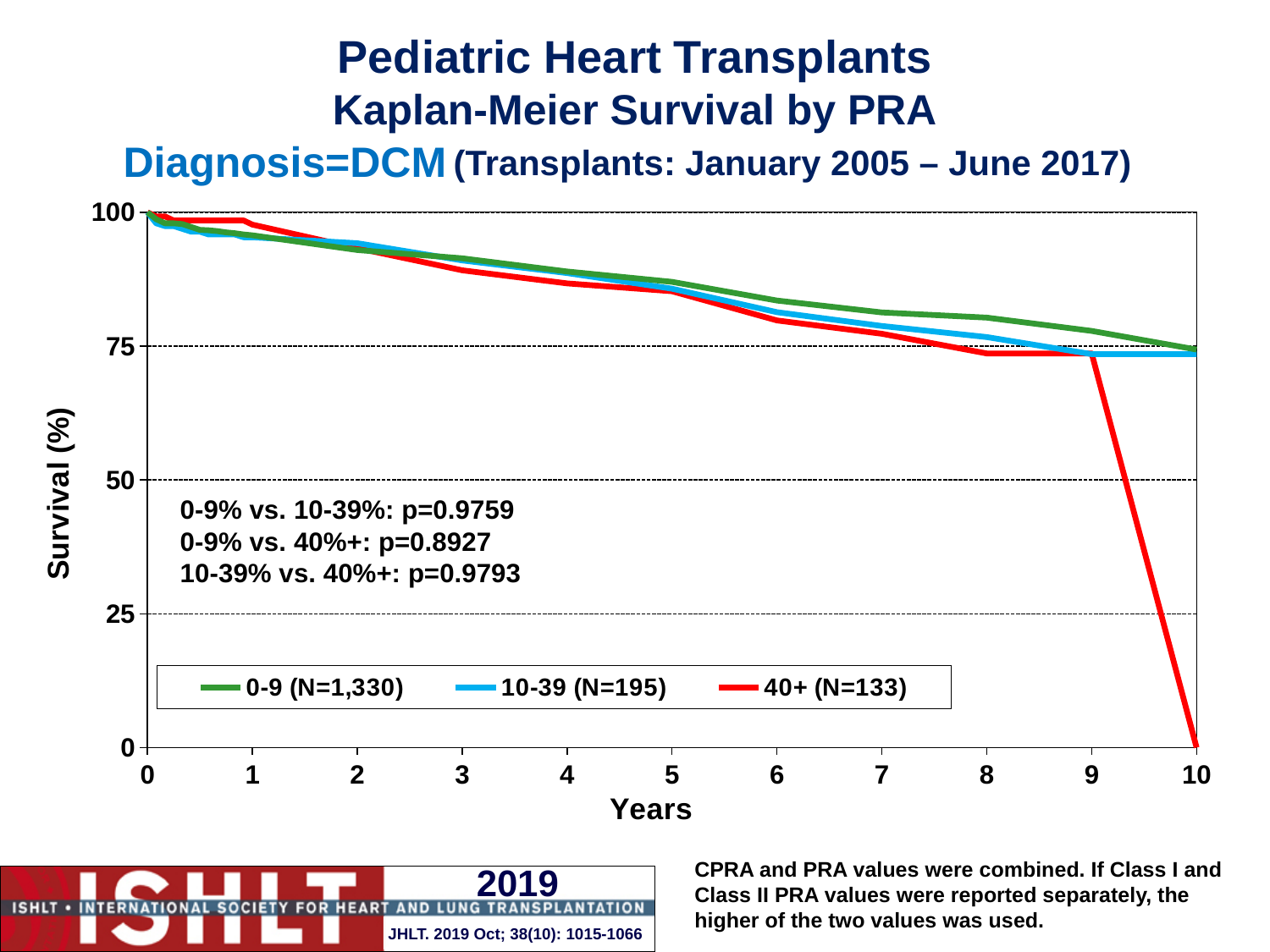
What is the N for the 40+ PRA group shown in the legend? 133 Do the survival curves rise or fall as years increase? fall Is the survival value for the 40+ group at year 8 greater or less than 75? less What kind of chart is shown on the slide? line chart How many series does the legend list? 3 Is the survival value for the 0-9 group at year 8 greater or less than 75? greater What is the survival value of the 40+ group at year 10? 0 Which group has the lowest survival at year 10? 40+ (N=133) What is the p-value for 0-9% vs. 40%+? p=0.8927 What is the N for the 0-9 PRA group shown in the legend? 1,330 What is the label of the y axis? Survival (%) Is the survival value for the 10-39 group at year 5 greater or less than 75? greater